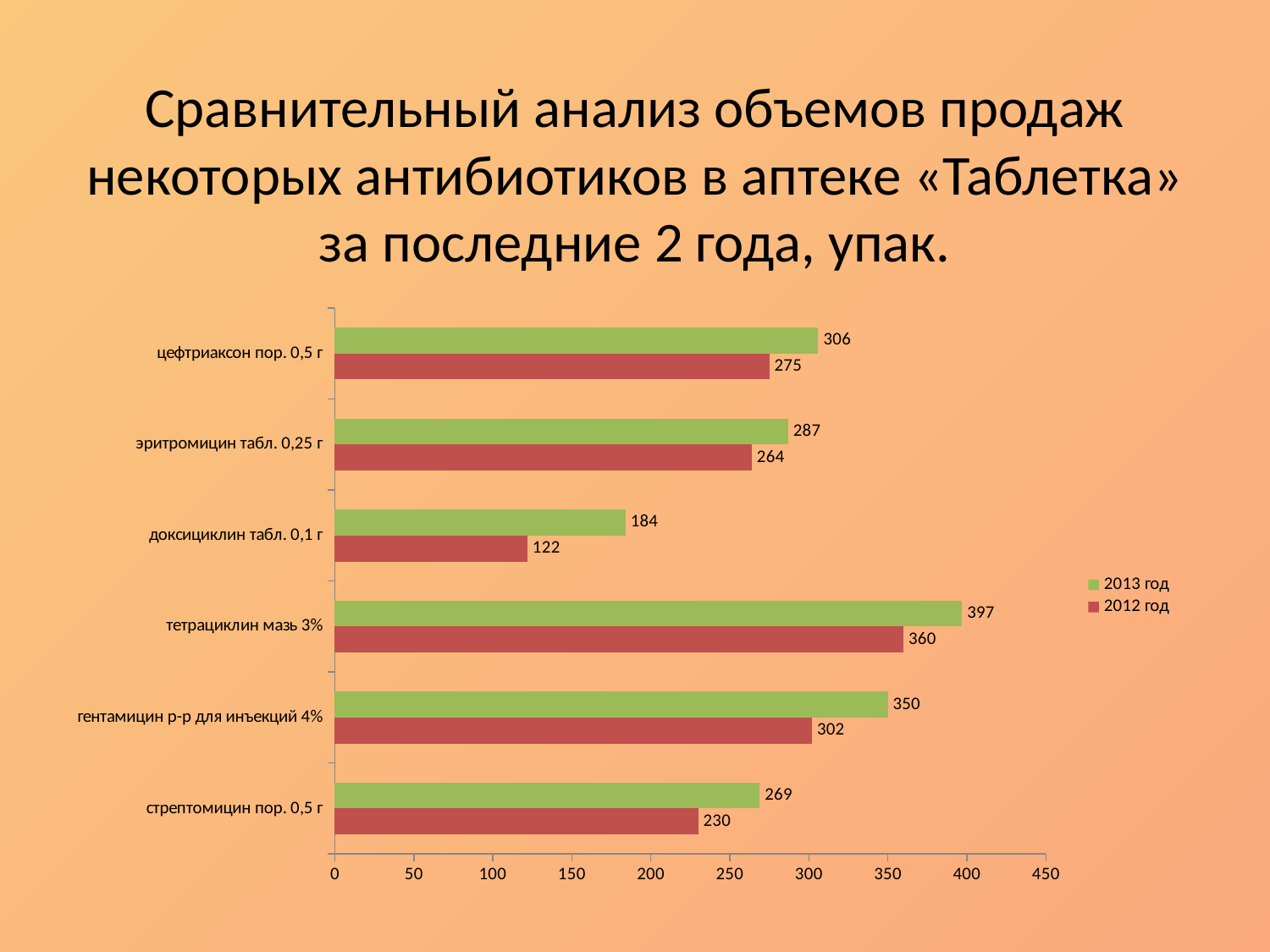
What kind of chart is shown on the slide? bar chart Which category has the lowest 2012 год value? доксициклин табл. 0,1 г How many categories are shown on the chart? 6 What is the 2013 год value for тетрациклин мазь 3%? 397 What is the 2012 год value for доксициклин табл. 0,1 г? 122 What is the difference between the 2013 год and 2012 год values for гентамицин р-р для инъекций 4%? 48 What is the difference between the 2013 год and 2012 год values for доксициклин табл. 0,1 г? 62 How many series does the legend list? 2 Which category has the highest 2013 год value? тетрациклин мазь 3% What is the 2012 год value for стрептомицин пор. 0,5 г? 230 Which colour represents the 2012 год series? red Which is larger: the 2013 год value for цефтриаксон пор. 0,5 г or the 2013 год value for эритромицин табл. 0,25 г? цефтриаксон пор. 0,5 г